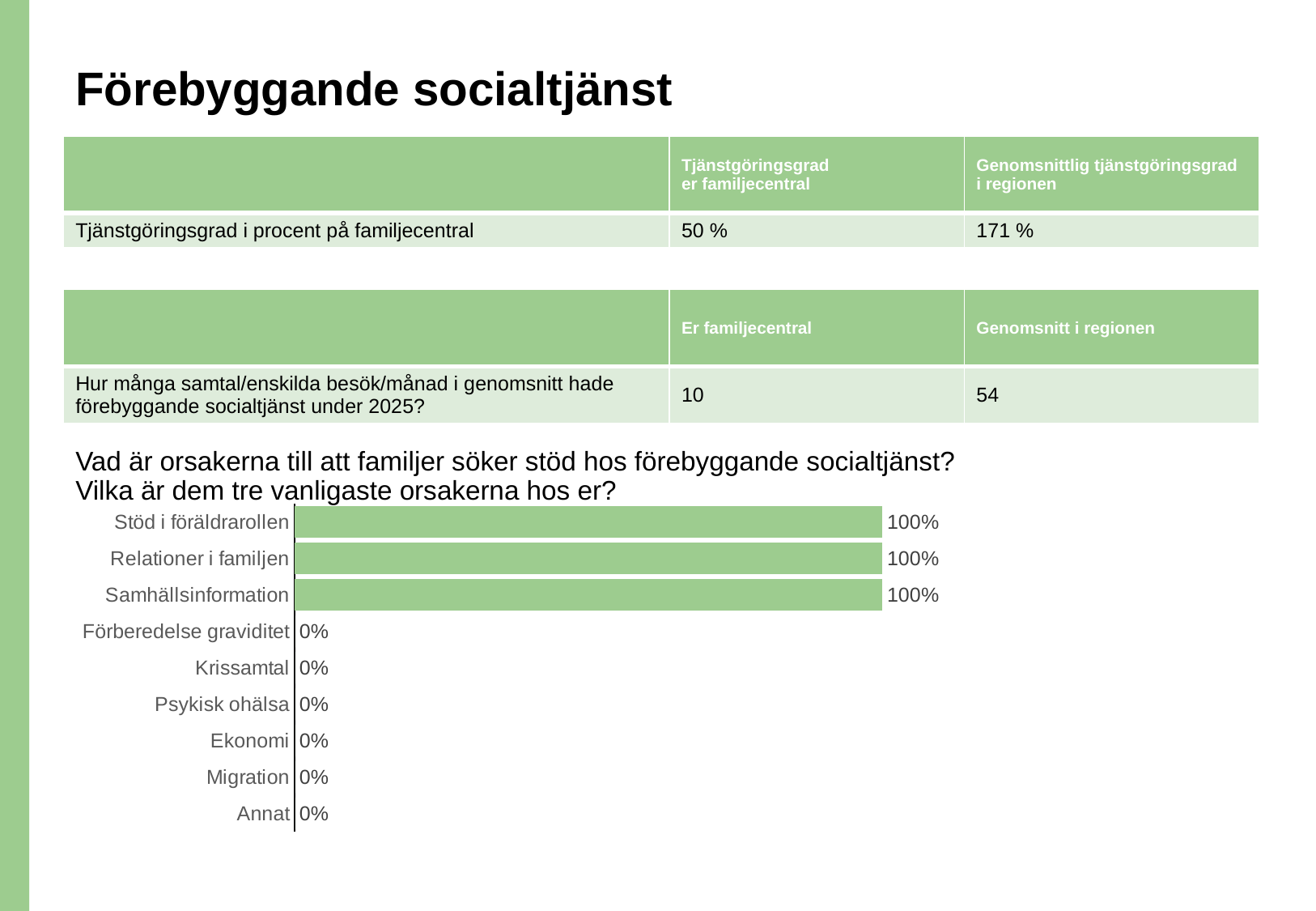
Which is larger in the bar chart, Relationer i familjen or Ekonomi? Relationer i familjen How many categories in the bar chart have a value of 0%? 6 What is the value for Krissamtal in the bar chart? 0% What is the value for Migration in the bar chart? 0% What is the difference between the values for Stöd i föräldrarollen and Psykisk ohälsa in the bar chart? 100% What is the value for Stöd i föräldrarollen in the bar chart? 100% What is the value for Annat in the bar chart? 0% How many categories in the bar chart have a value of 100%? 3 What is the value for Samhällsinformation in the bar chart? 100% How many categories does the bar chart show? 9 What colour are the bars in the bar chart? green What kind of chart is shown on the slide? bar chart